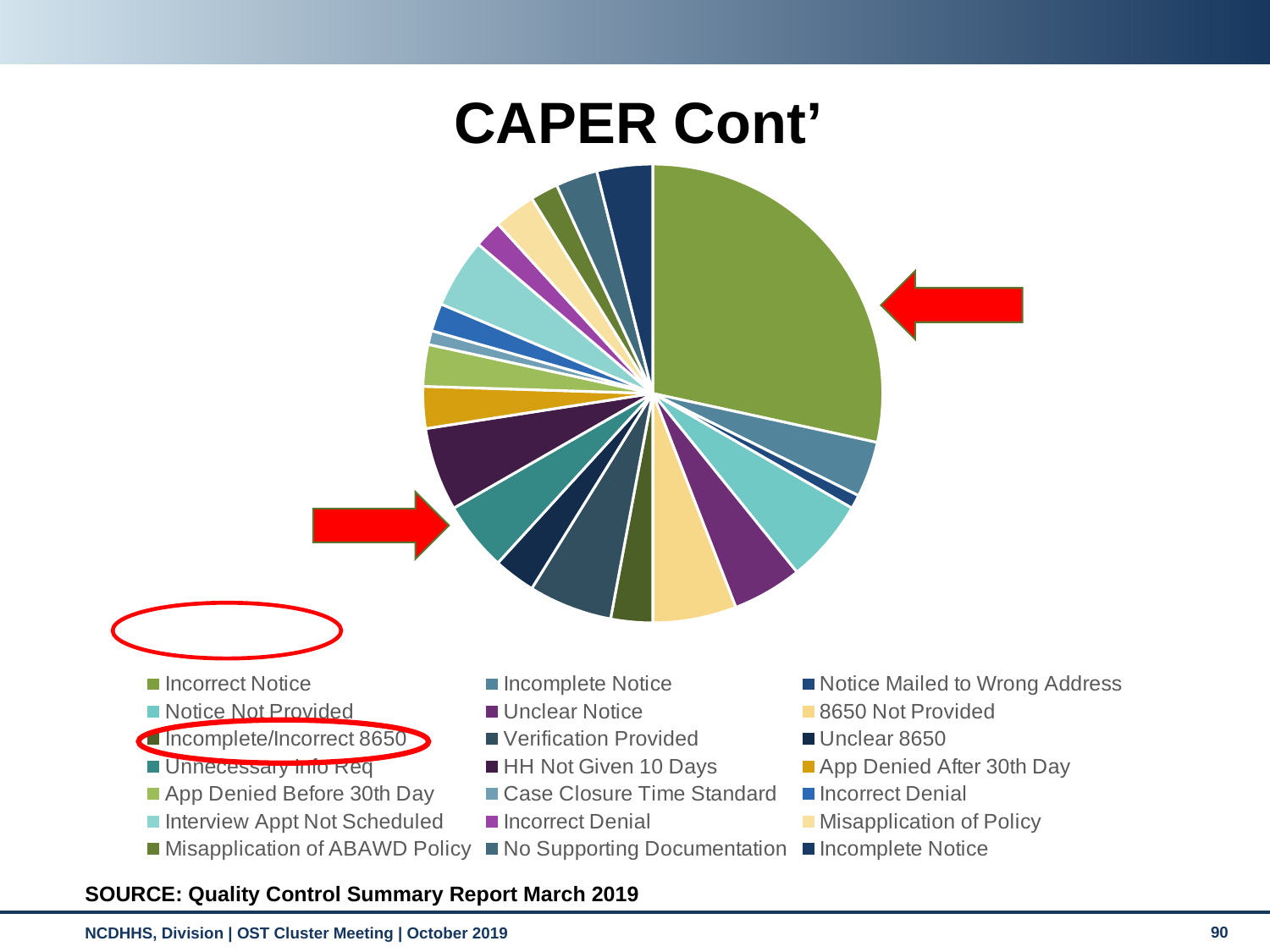
Which slice is larger, Incorrect Notice or Notice Not Provided? Incorrect Notice What is the title of the slide containing the pie chart? CAPER Cont' What source is cited for the pie chart data? Quality Control Summary Report March 2019 Which slice is larger, Incorrect Notice or HH Not Given 10 Days? Incorrect Notice How many slices does the pie chart have? 21 What kind of chart is shown on the slide? pie chart How many categories does the legend list? 21 Which slice is larger, Incorrect Notice or 8650 Not Provided? Incorrect Notice Which category has the largest slice of the pie? Incorrect Notice